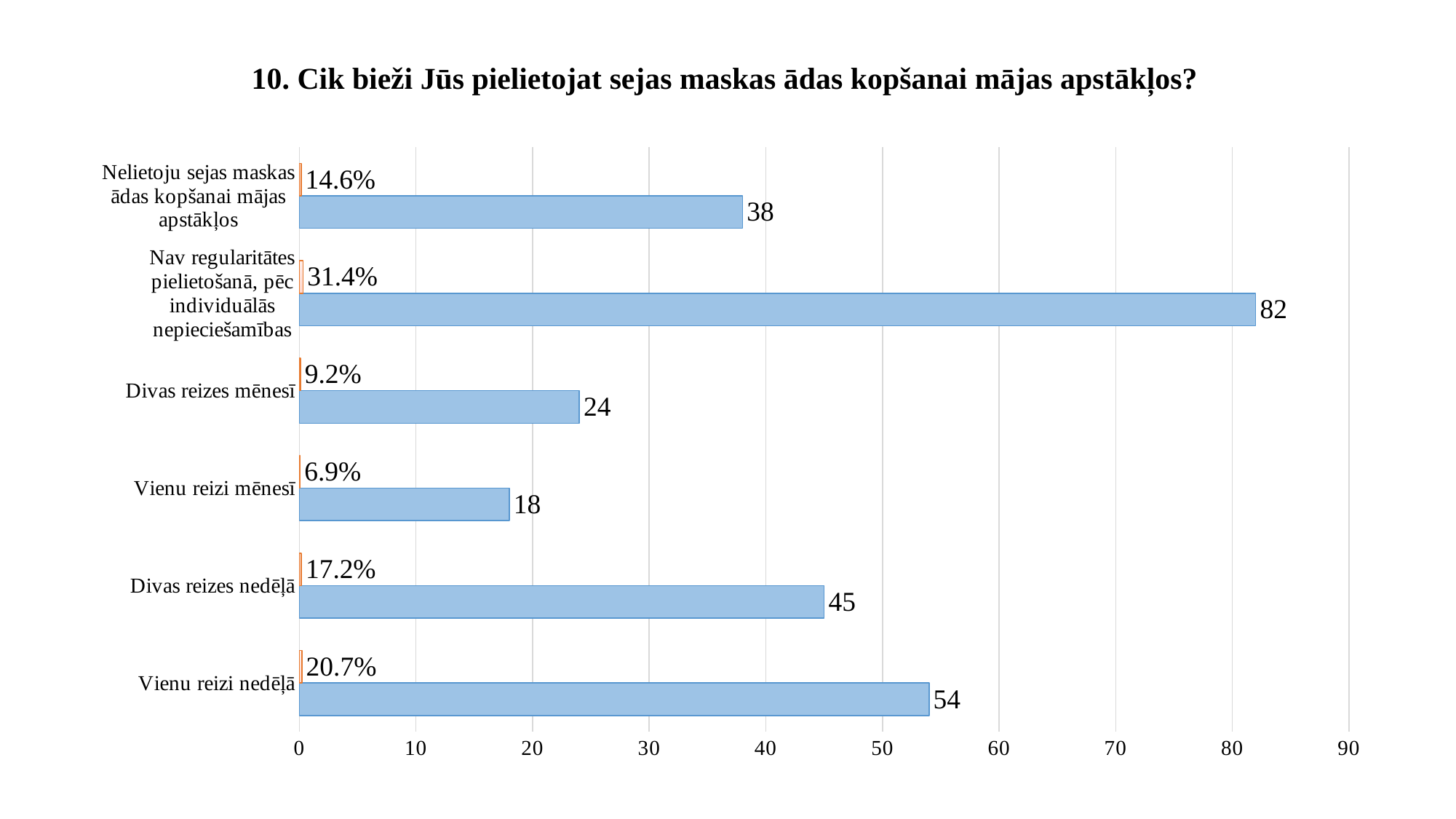
What percentage is shown for "Nelietoju sejas maskas ādas kopšanai mājas apstākļos"? 14.6% Is the count for "Divas reizes nedēļā" greater or less than 40? greater How many categories are shown on the chart? 6 What is the difference in count between "Vienu reizi nedēļā" and "Divas reizes nedēļā"? 9 What is the title of the chart? 10. Cik bieži Jūs pielietojat sejas maskas ādas kopšanai mājas apstākļos? What kind of chart is shown on the slide? bar chart What is the count value for "Vienu reizi nedēļā"? 54 What is the count value for "Nav regularitātes pielietošanā, pēc individuālās nepieciešamības"? 82 Which category has the lowest count? Vienu reizi mēnesī Which category has the highest count? Nav regularitātes pielietošanā, pēc individuālās nepieciešamības What percentage is shown for "Divas reizes mēnesī"? 9.2% Which has a larger count, "Divas reizes mēnesī" or "Nelietoju sejas maskas ādas kopšanai mājas apstākļos"? Nelietoju sejas maskas ādas kopšanai mājas apstākļos